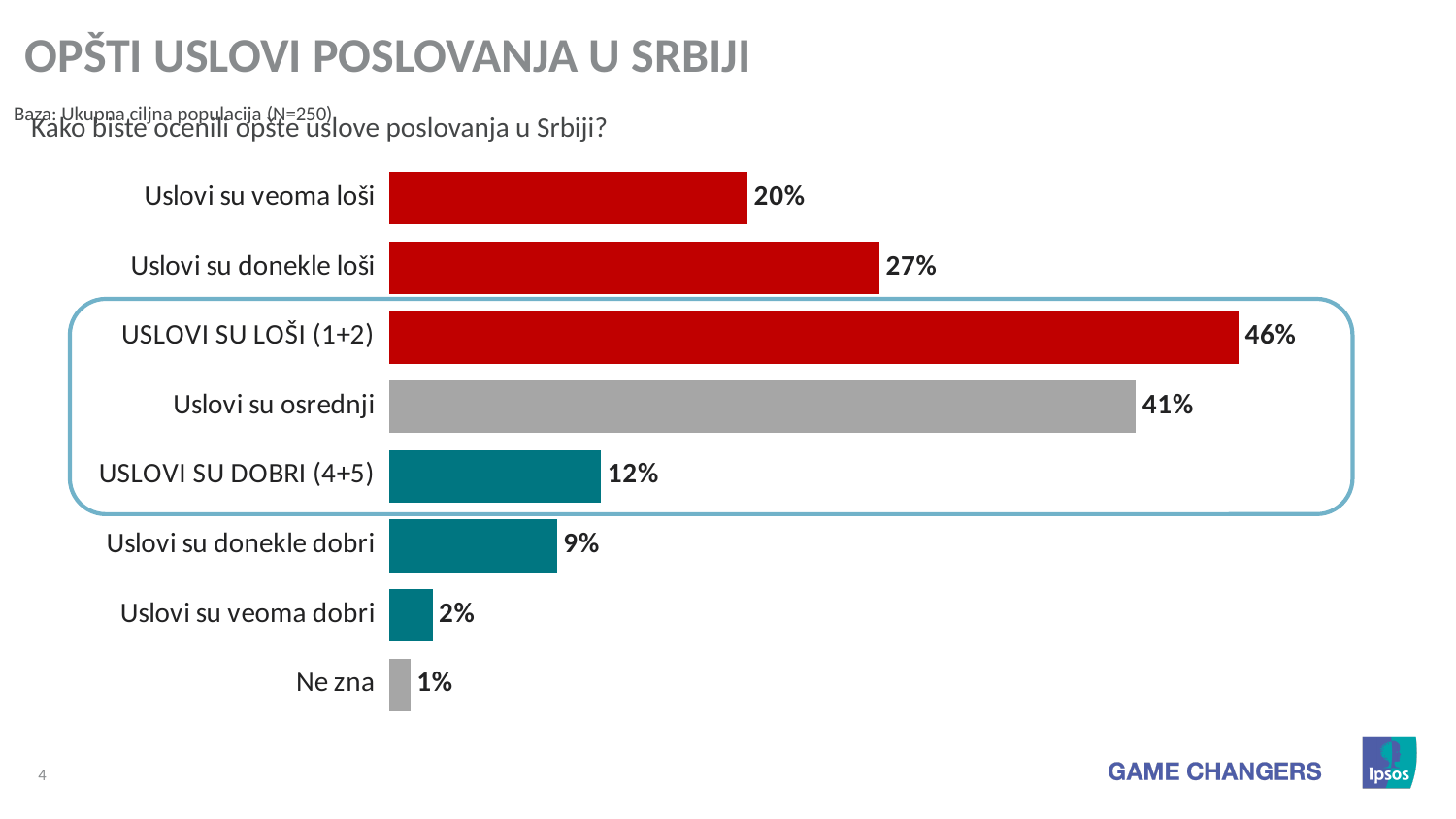
Which is larger, 'Uslovi su donekle dobri' or 'Uslovi su veoma dobri'? Uslovi su donekle dobri What percentage is shown for 'Uslovi su veoma loši'? 20% Which category has the lowest value? Ne zna What percentage is shown for 'Uslovi su osrednji'? 41% What percentage is shown for 'USLOVI SU DOBRI (4+5)'? 12% What kind of chart is shown on the slide? Bar chart What percentage is shown for 'Ne zna'? 1% What percentage is shown for 'Uslovi su donekle loši'? 27% How many categories are shown in the chart? 8 What is the difference between 'USLOVI SU LOŠI (1+2)' and 'USLOVI SU DOBRI (4+5)'? 34% What percentage is shown for 'USLOVI SU LOŠI (1+2)'? 46% Which category has the highest value? USLOVI SU LOŠI (1+2)